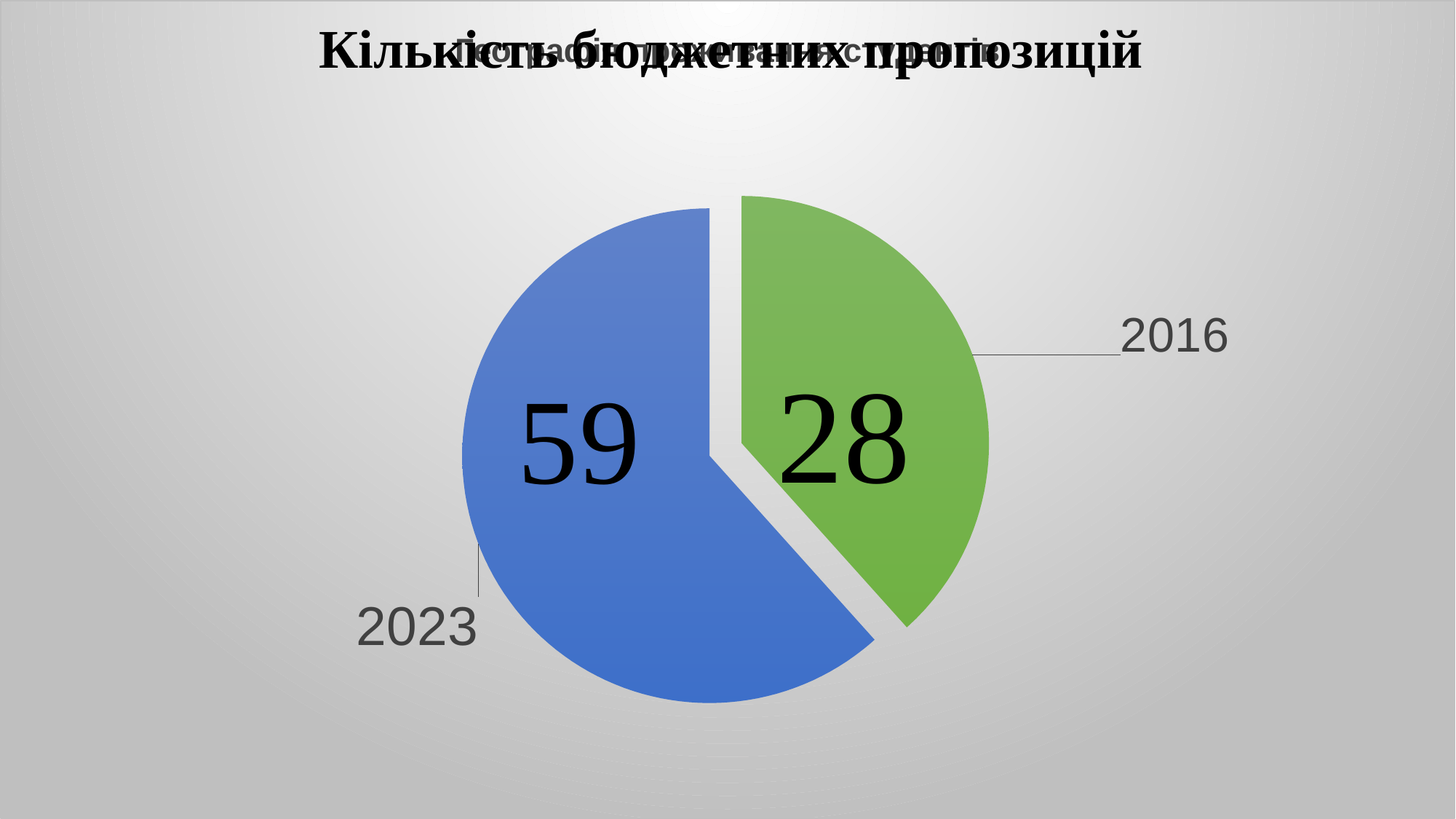
What colour is the slice for 2016? green What is the difference between the values for 2023 and 2016? 31 What is the value for 2016 in the pie chart? 28 Which category has the smallest slice in the pie chart? 2016 What is the title of the slide? Кількість бюджетних пропозицій What is the value for 2023 in the pie chart? 59 What is the total of the two values shown in the pie chart? 87 Which category has the largest slice in the pie chart? 2023 What type of chart is shown on the slide? pie chart How many slices does the pie chart have? 2 Which is larger, the value for 2023 or the value for 2016? 2023